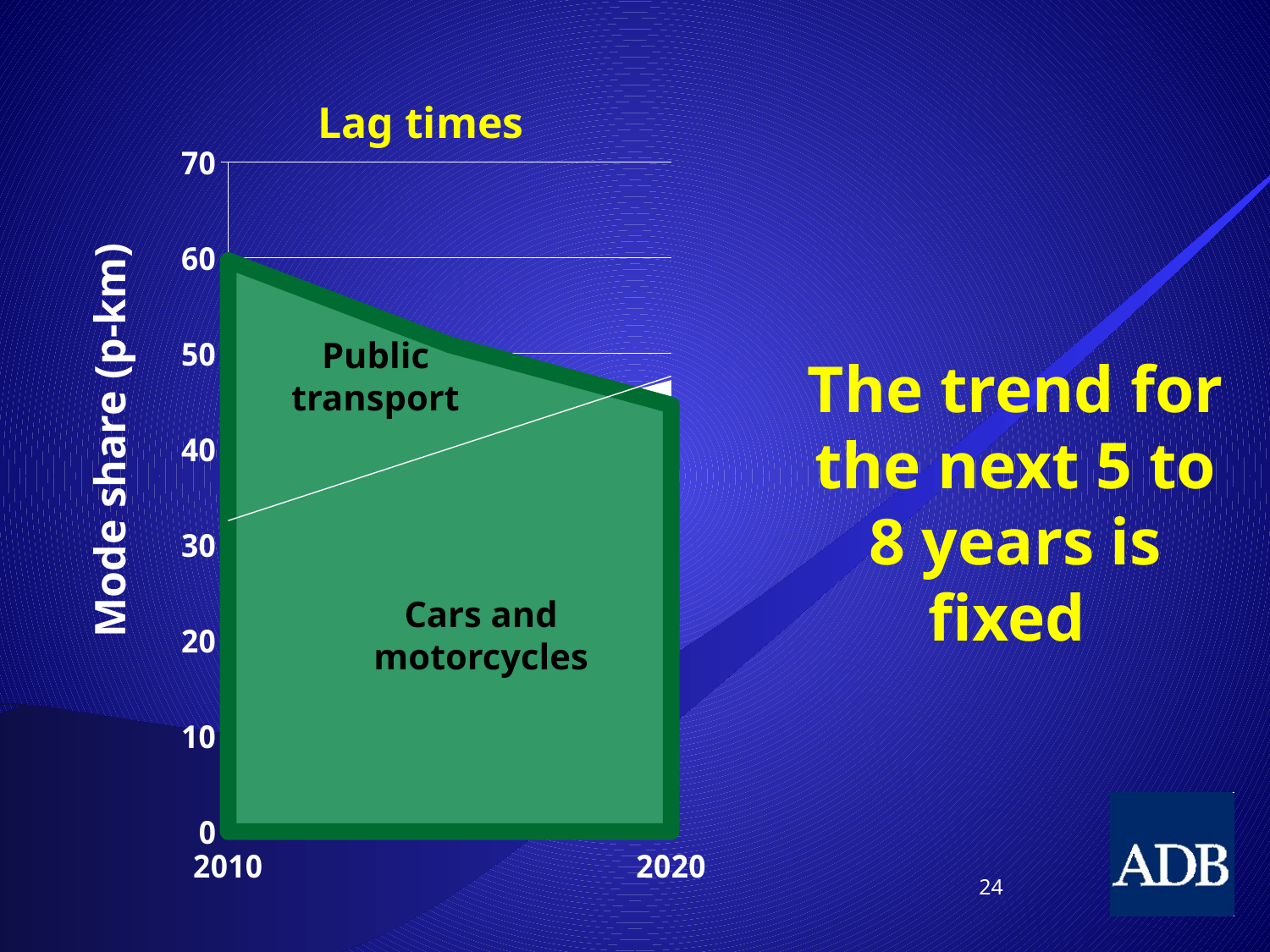
What kind of chart is shown on the slide? area chart What is the first year shown on the horizontal axis? 2010 How many labelled regions are shown in the chart? 2 Does the top edge of the green area rise or fall from 2010 to 2020? fall Is the value of the white line in 2010 greater or less than 40? less Does the white line rise or fall from 2010 to 2020? rise Is the top of the green area in 2020 greater or less than 50? less Is the top of the green area in 2020 greater or less than 40? greater What is the highest value marked on the vertical axis? 70 What is the label on the vertical axis of the chart? Mode share (p-km) What is the last year shown on the horizontal axis? 2020 What is the title of the chart? Lag times